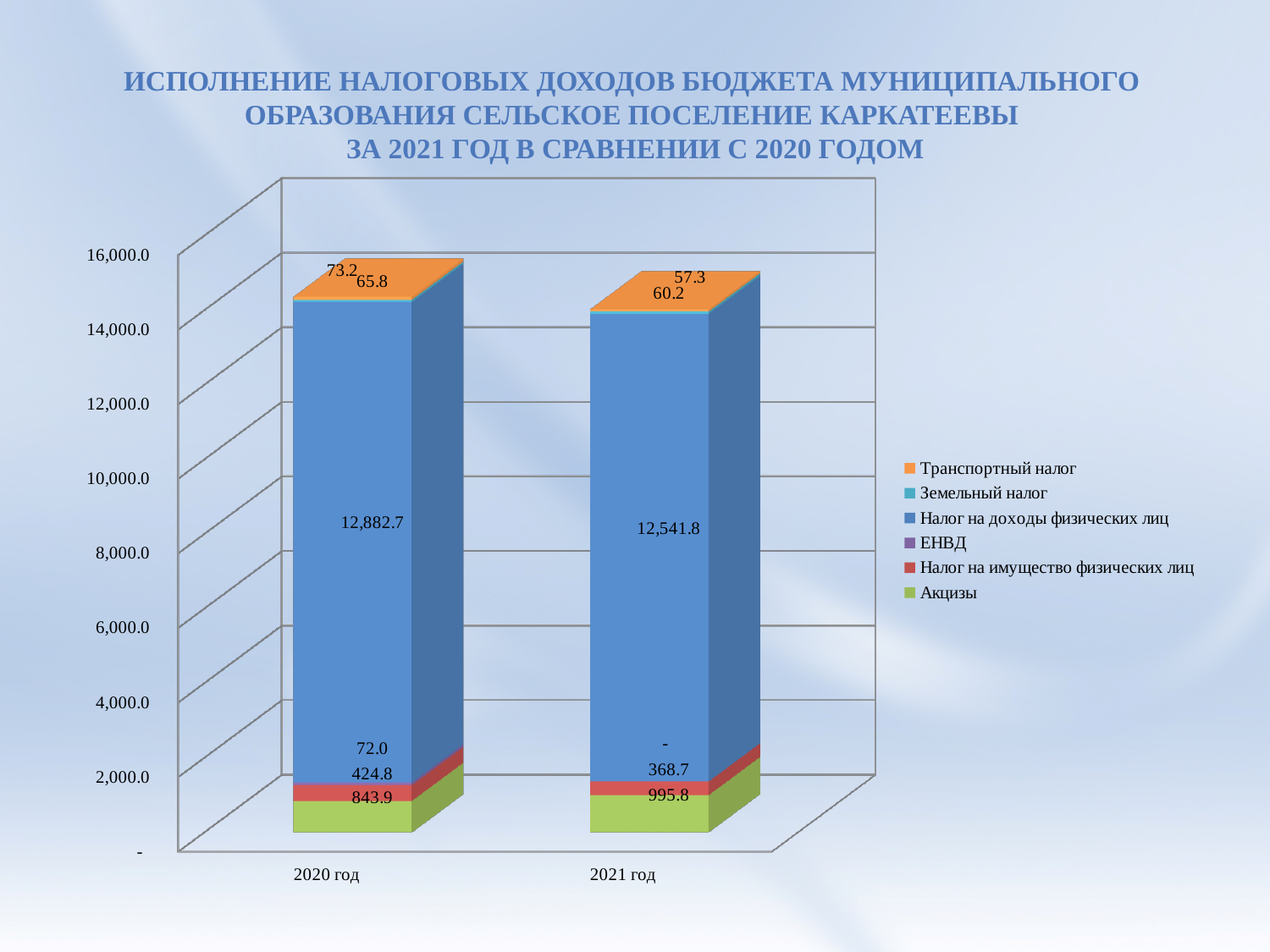
What is the difference between Налог на имущество физических лиц in 2020 год and 2021 год? 56.1 What is the value of Налог на доходы физических лиц for 2021 год? 12,541.8 What is the value of Налог на имущество физических лиц for 2021 год? 368.7 What is the value of Акцизы for 2020 год? 843.9 What is the value of Налог на доходы физических лиц for 2020 год? 12,882.7 What is the value of ЕНВД for 2020 год? 72.0 How many series does the legend list? 6 What kind of chart is shown on the slide? Stacked bar chart By how much did Акцизы increase from 2020 год to 2021 год? 151.9 Which year has the larger value for Налог на доходы физических лиц, 2020 год or 2021 год? 2020 год What is the value of Акцизы for 2021 год? 995.8 How many categories (years) are shown on the x axis? 2